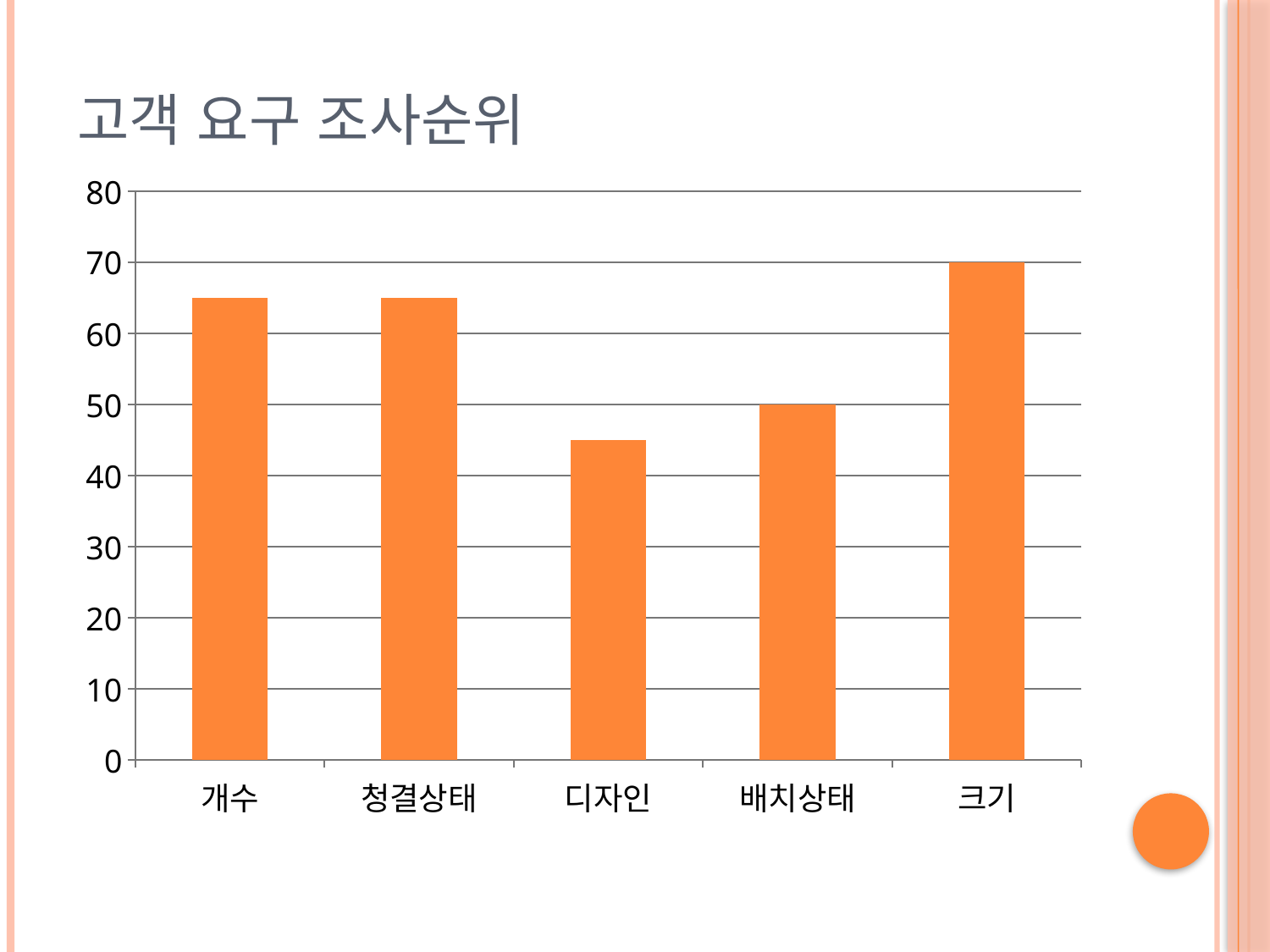
What kind of chart is shown on the slide? bar chart Which category has the lowest value? 디자인 What is the value for 배치상태? 50 Is the value for 디자인 greater or less than 50? less Which is larger, the value for 크기 or the value for 배치상태? 크기 Is the value for 개수 greater or less than 60? greater What is the difference between the values for 크기 and 배치상태? 20 Is the value for 청결상태 greater or less than 70? less What is the value for 크기? 70 Which category has the highest value? 크기 How many categories are shown on the x axis? 5 Which is larger, the value for 디자인 or the value for 개수? 개수